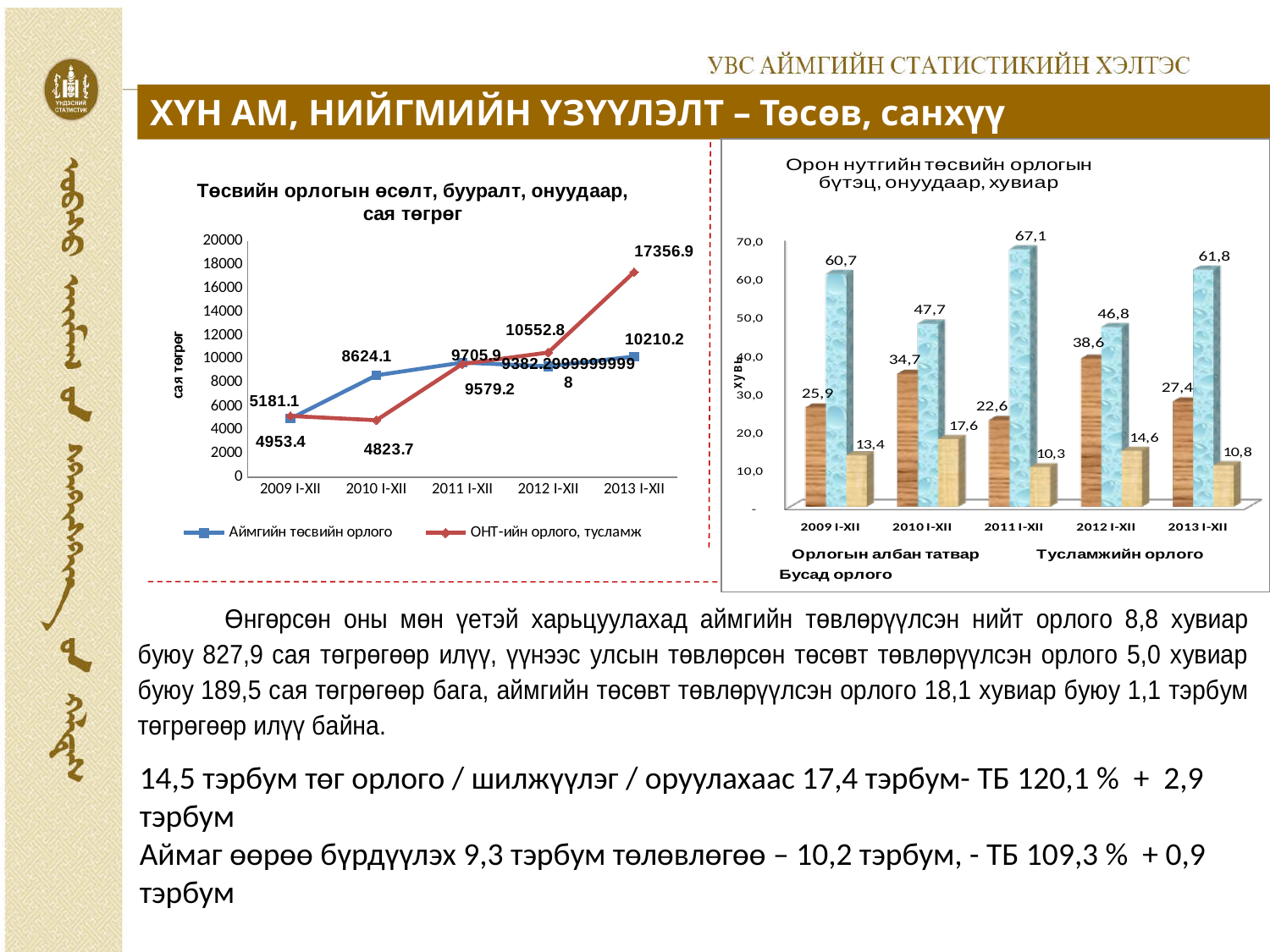
What kind of chart is the left chart 'Төсвийн орлогын өсөлт, бууралт, онуудаар, сая төгрөг'? Line chart In the right chart 'Орон нутгийн төсвийн орлогын бүтэц, онуудаар, хувиар', what is the value of Тусламжийн орлого for 2011 I-XII? 67,1 In the right chart 'Орон нутгийн төсвийн орлогын бүтэц, онуудаар, хувиар', in which year is Орлогын албан татвар highest? 2012 I-XII In the left chart 'Төсвийн орлогын өсөлт, бууралт, онуудаар, сая төгрөг', which series has the higher value in 2010 I-XII? Аймгийн төсвийн орлого In the right chart 'Орон нутгийн төсвийн орлогын бүтэц, онуудаар, хувиар', how many year categories are shown on the x axis? 5 In the left chart 'Төсвийн орлогын өсөлт, бууралт, онуудаар, сая төгрөг', what is the value of ОНТ-ийн орлого, тусламж for 2013 I-XII? 17356.9 In the left chart 'Төсвийн орлогын өсөлт, бууралт, онуудаар, сая төгрөг', what is the difference between ОНТ-ийн орлого, тусламж and Аймгийн төсвийн орлого in 2013 I-XII? 7146.7 What kind of chart is the right chart 'Орон нутгийн төсвийн орлогын бүтэц, онуудаар, хувиар'? Bar chart In the left chart 'Төсвийн орлогын өсөлт, бууралт, онуудаар, сая төгрөг', in which year is ОНТ-ийн орлого, тусламж lowest? 2010 I-XII In the left chart 'Төсвийн орлогын өсөлт, бууралт, онуудаар, сая төгрөг', what is the value of Аймгийн төсвийн орлого for 2010 I-XII? 8624.1 In the left chart 'Төсвийн орлогын өсөлт, бууралт, онуудаар, сая төгрөг', how many series does the legend list? 2 In the right chart 'Орон нутгийн төсвийн орлогын бүтэц, онуудаар, хувиар', what is the difference between Тусламжийн орлого and Орлогын албан татвар in 2009 I-XII? 34,8